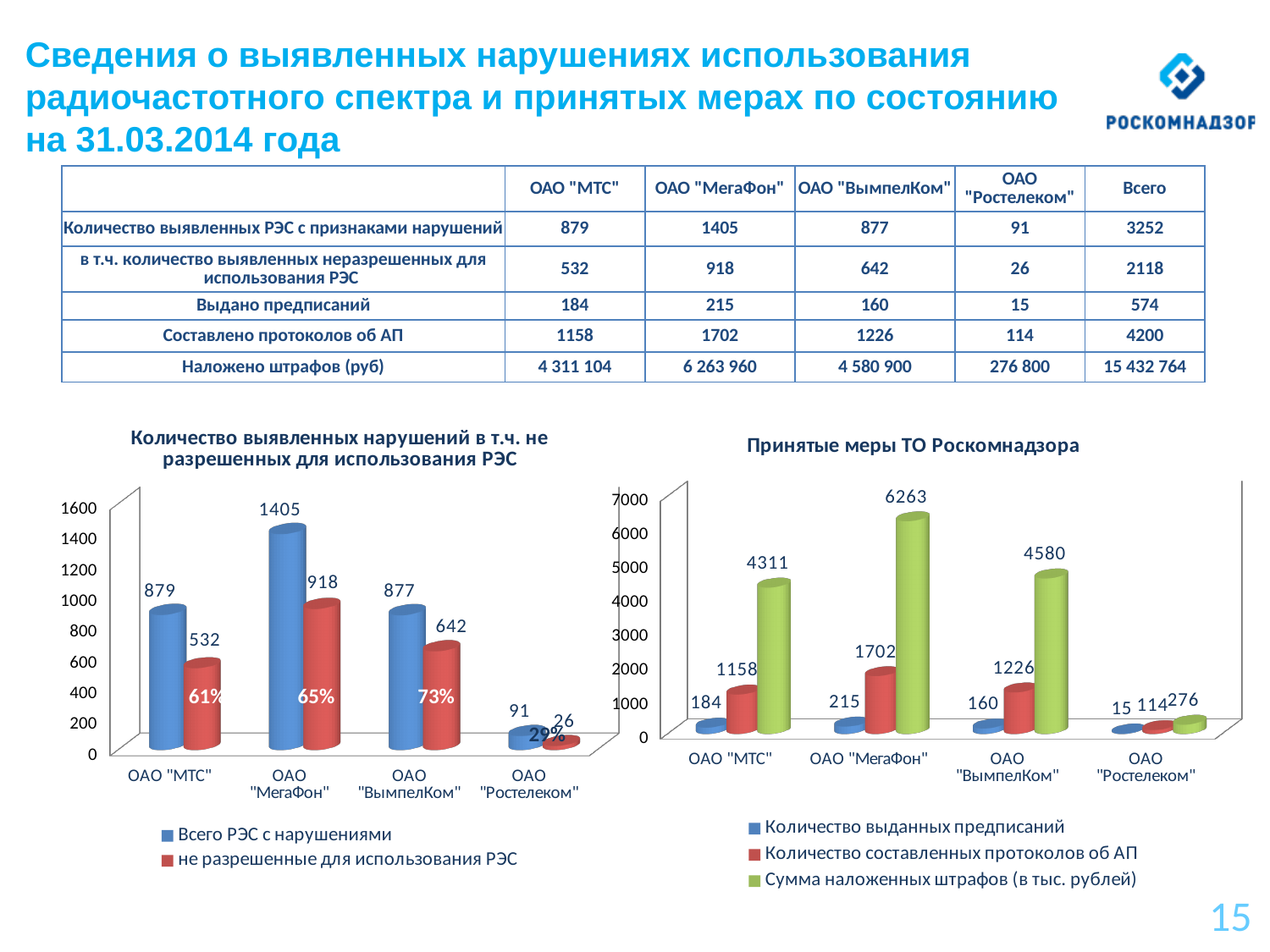
In the chart 'Количество выявленных нарушений в т.ч. не разрешенных для использования РЭС', what is the value of 'Всего РЭС с нарушениями' for ОАО "МегаФон"? 1405 In the chart 'Принятые меры ТО Роскомнадзора', which operator has the highest 'Сумма наложенных штрафов (в тыс. рублей)'? ОАО "МегаФон" In the chart 'Количество выявленных нарушений в т.ч. не разрешенных для использования РЭС', what is the difference between 'Всего РЭС с нарушениями' and 'не разрешенные для использования РЭС' for ОАО "МТС"? 347 In the chart 'Принятые меры ТО Роскомнадзора', what is the value of 'Сумма наложенных штрафов (в тыс. рублей)' for ОАО "МегаФон"? 6263 In the chart 'Количество выявленных нарушений в т.ч. не разрешенных для использования РЭС', what is the value of 'не разрешенные для использования РЭС' for ОАО "ВымпелКом"? 642 How many series does the legend of the chart 'Принятые меры ТО Роскомнадзора' list? 3 What type of chart is 'Принятые меры ТО Роскомнадзора'? Bar chart In the chart 'Количество выявленных нарушений в т.ч. не разрешенных для использования РЭС', which operator has the lowest value of 'Всего РЭС с нарушениями'? ОАО "Ростелеком" In the chart 'Принятые меры ТО Роскомнадзора', what is the value of 'Количество составленных протоколов об АП' for ОАО "ВымпелКом"? 1226 In the chart 'Количество выявленных нарушений в т.ч. не разрешенных для использования РЭС', what percentage label is shown on the ОАО "ВымпелКом" bar? 73% How many series does the legend of the chart 'Количество выявленных нарушений в т.ч. не разрешенных для использования РЭС' list? 2 In the chart 'Принятые меры ТО Роскомнадзора', which is larger: 'Количество составленных протоколов об АП' for ОАО "МТС" or for ОАО "ВымпелКом"? ОАО "ВымпелКом"